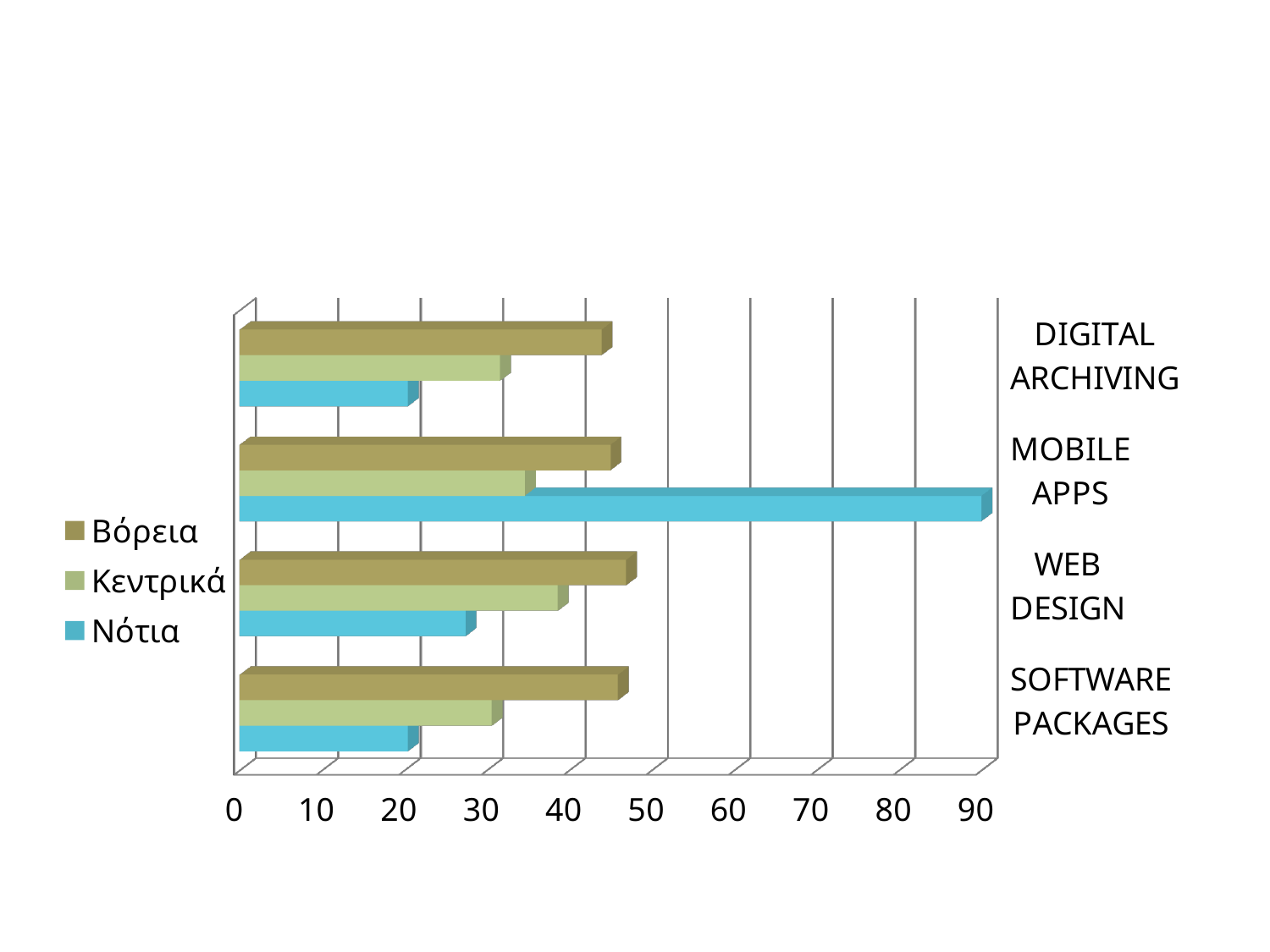
What are the three series names listed in the legend? Βόρεια, Κεντρικά, Νότια For WEB DESIGN, which series has the larger value, Βόρεια or Νότια? Βόρεια Which category has the highest value for the Νότια series? MOBILE APPS Which category has the highest value for the Κεντρικά series? WEB DESIGN Is the Νότια value for DIGITAL ARCHIVING greater or less than 30? less For MOBILE APPS, which series has the larger value, Κεντρικά or Νότια? Νότια How many series does the legend list? 3 Is the Νότια value for MOBILE APPS greater or less than 80? greater Is the Βόρεια value for WEB DESIGN greater or less than 40? greater How many categories are shown on the chart? 4 What kind of chart is shown on the slide? Bar chart